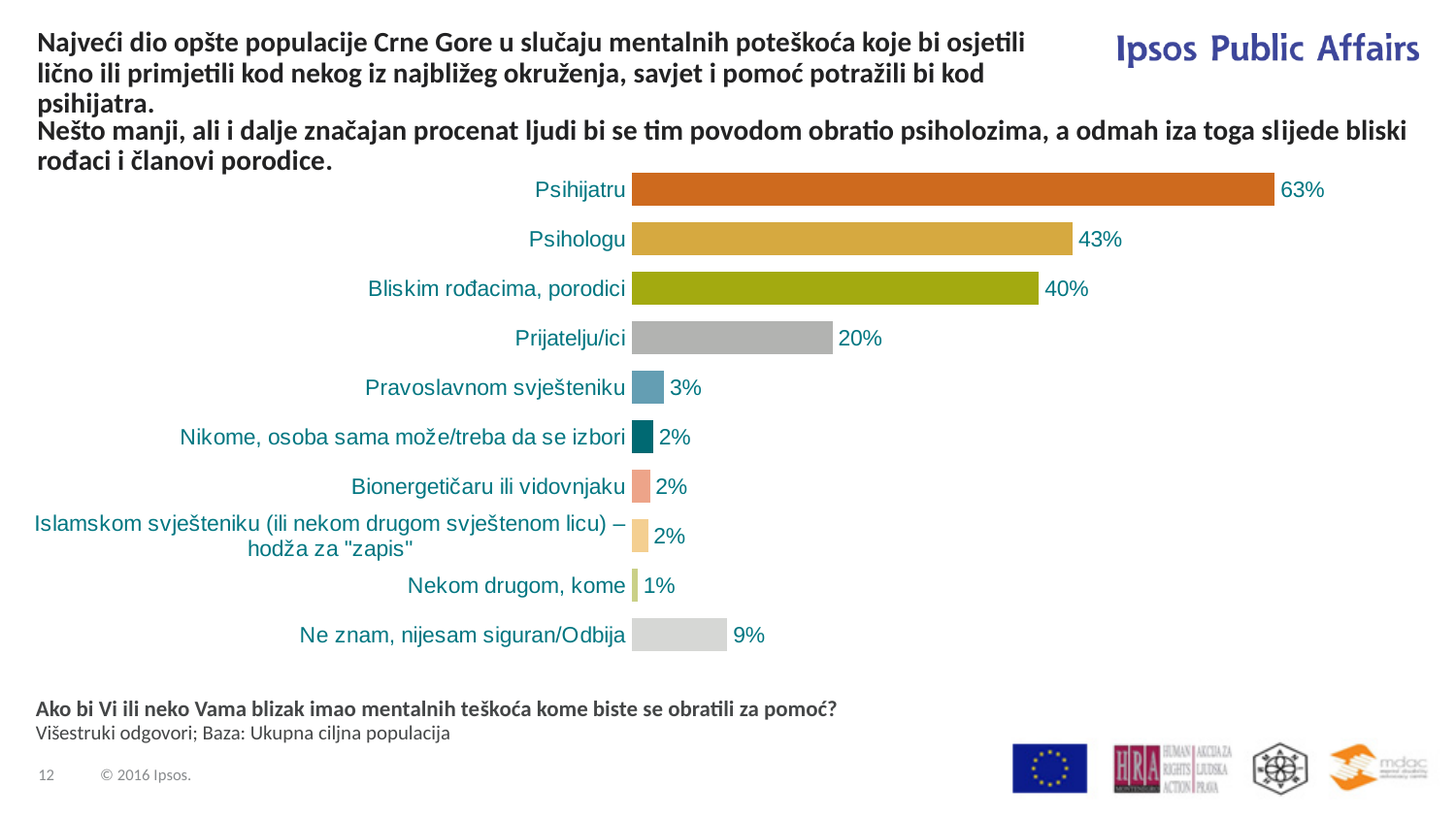
Which category has the lowest value in the chart? Nekom drugom, kome What is the value for Ne znam, nijesam siguran/Odbija? 9% What is the difference between the values for Bliskim rođacima, porodici and Prijatelju/ici? 20 percentage points What percentage of respondents would seek help from a psychiatrist (Psihijatru)? 63% What colour is the bar for Psihijatru? Orange How many categories are shown in the chart? 10 What percentage is shown for Prijatelju/ici? 20% What type of chart is shown on the slide? Bar chart Which category has the highest value in the chart? Psihijatru What is the difference between the values for Psihijatru and Psihologu? 20 percentage points Which is larger, the value for Pravoslavnom svješteniku or the value for Ne znam, nijesam siguran/Odbija? Ne znam, nijesam siguran/Odbija What is the value shown for Psihologu? 43%